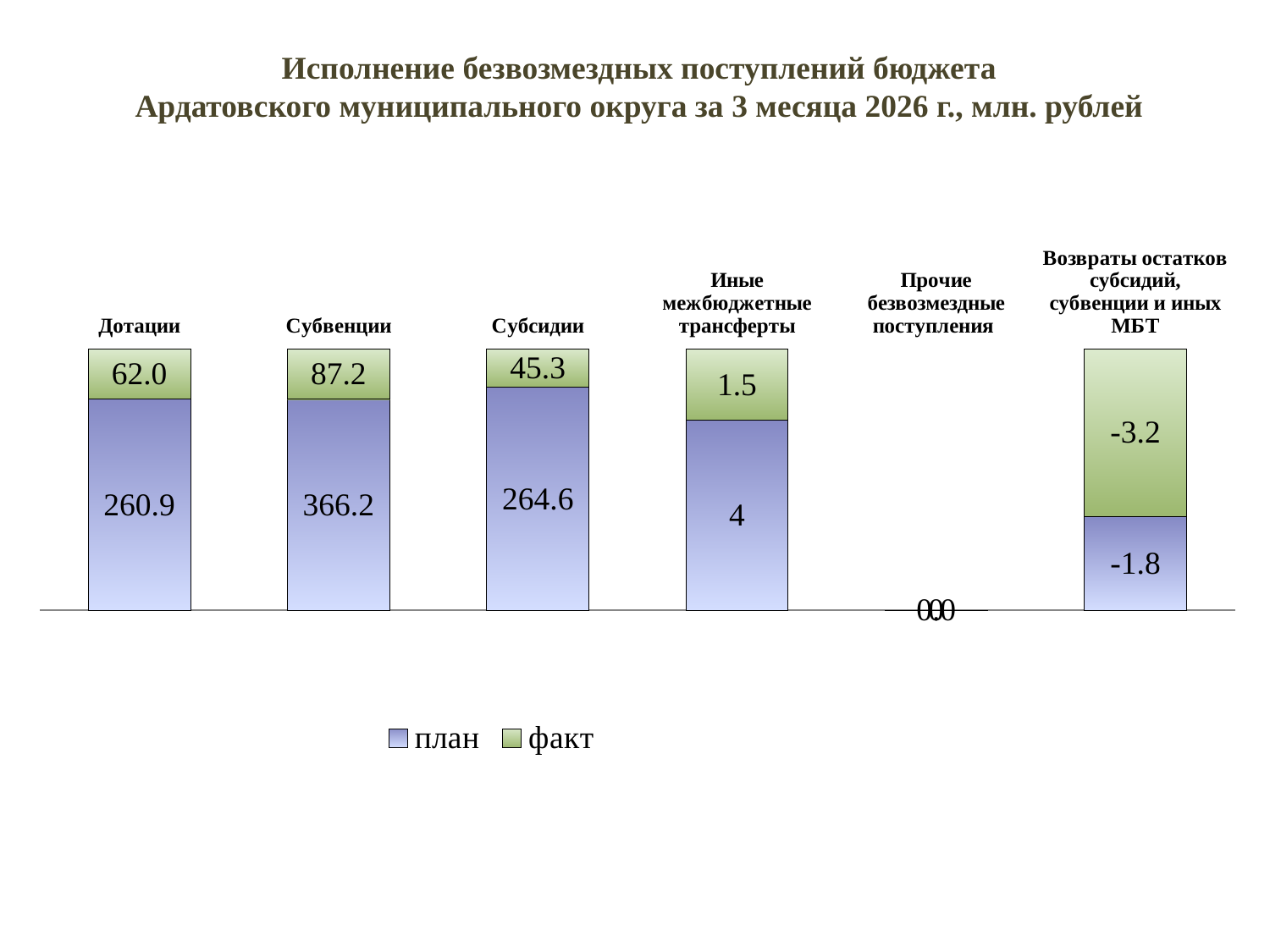
What is the план value for Иные межбюджетные трансферты? 4 Which category has the lowest факт value? Возвраты остатков субсидий, субвенции и иных МБТ What is the план value for Дотации? 260.9 What is the difference between the план values for Субвенции and Дотации? 105.3 What is the total of the план and факт values in the Дотации bar? 322.9 What kind of chart is shown on the slide? Stacked bar chart Which is larger, the факт value for Дотации or the факт value for Субсидии? Дотации Which category has the highest план value? Субвенции How many series does the legend list? 2 How many categories are shown on the x axis? 6 What is the факт value for Возвраты остатков субсидий, субвенции и иных МБТ? -3.2 What is the факт value for Субвенции? 87.2